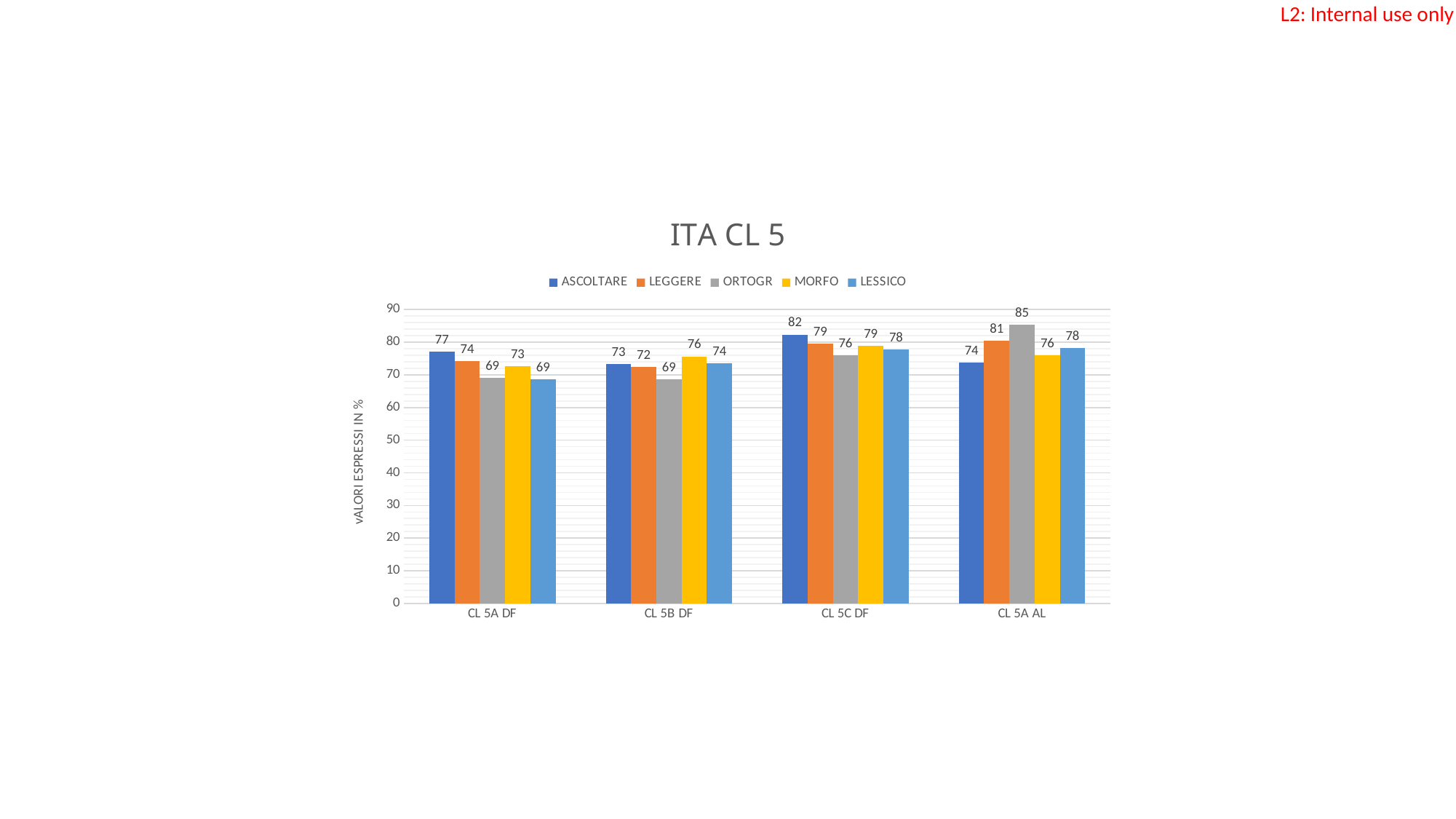
How many categories are shown on the x axis? 4 What is the ORTOGR value for CL 5A AL? 85 How many series does the legend list? 5 Which is larger for CL 5A AL: LEGGERE or MORFO? LEGGERE Which category has the highest ORTOGR value? CL 5A AL What kind of chart is shown? bar chart What is the title of the chart? ITA CL 5 What is the ASCOLTARE value for CL 5C DF? 82 Which category has the lowest ASCOLTARE value? CL 5B DF What is the MORFO value for CL 5B DF? 76 What is the difference between the ASCOLTARE values for CL 5C DF and CL 5B DF? 9 What is the LESSICO value for CL 5A DF? 69